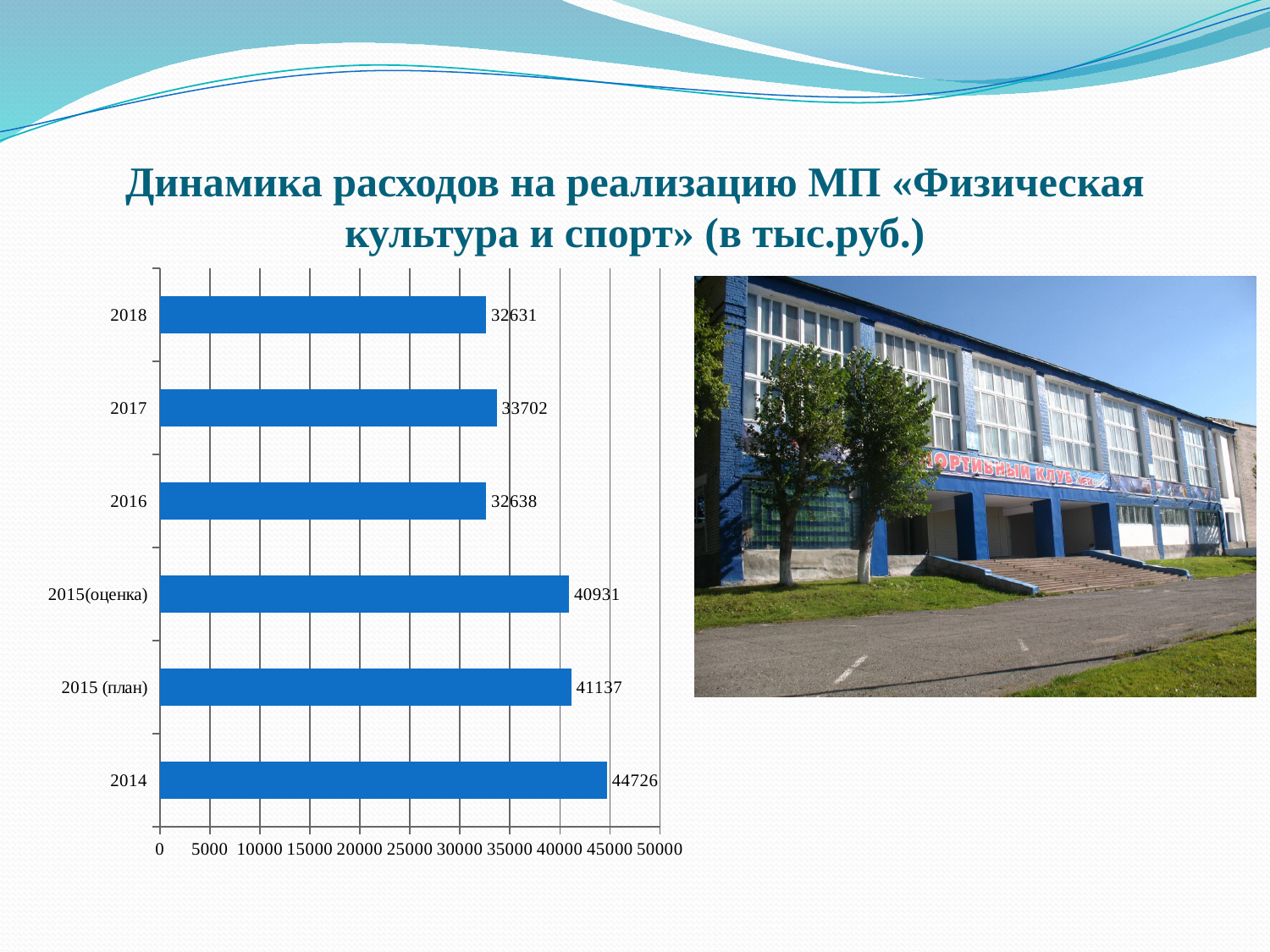
What is the difference between the values for 2015 (план) and 2015(оценка)? 206 Is the value for 2016 greater or less than 35000? less What is the difference between the values for 2014 and 2018? 12095 What is the value for 2015(оценка)? 40931 How many categories are shown on the chart? 6 What is the value for 2017? 33702 What is the value for 2015 (план)? 41137 Which is larger, the value for 2017 or the value for 2016? 2017 Which category has the highest value? 2014 Which category has the lowest value? 2018 What kind of chart is shown on the slide? bar chart What is the value for 2014? 44726